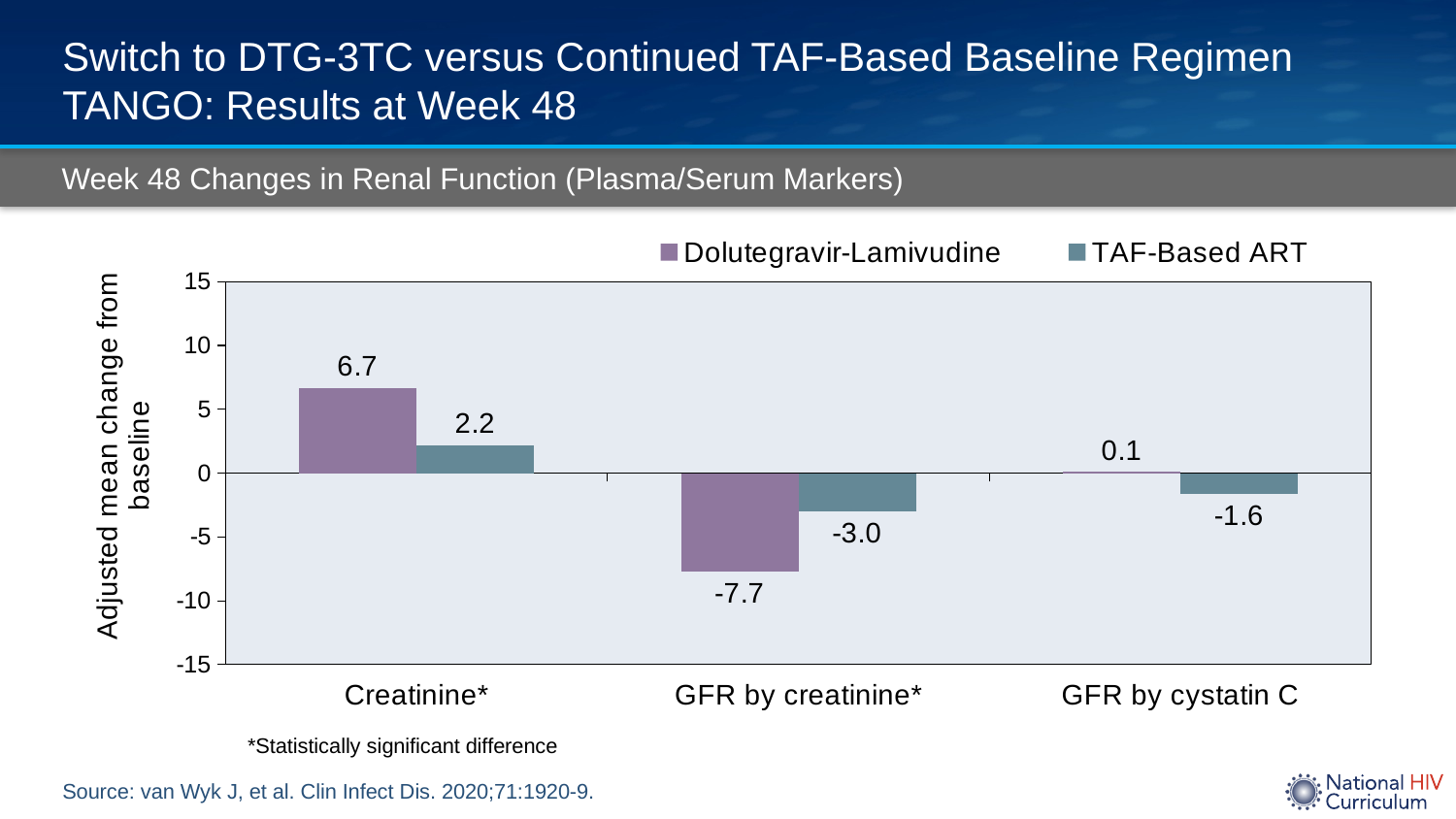
Which category has the lowest value for Dolutegravir-Lamivudine? GFR by creatinine* What is the adjusted mean change from baseline in Creatinine* for Dolutegravir-Lamivudine? 6.7 Which category has the highest value for TAF-Based ART? Creatinine* What is the adjusted mean change from baseline in GFR by cystatin C for Dolutegravir-Lamivudine? 0.1 What is the difference between the Dolutegravir-Lamivudine and TAF-Based ART values for Creatinine*? 4.5 What is the adjusted mean change from baseline in GFR by creatinine* for TAF-Based ART? -3.0 What is the difference between the TAF-Based ART and Dolutegravir-Lamivudine values for GFR by creatinine*? 4.7 How many series does the legend list? 2 What kind of chart is shown on the slide? Bar chart How many categories are shown on the x axis? 3 For GFR by cystatin C, which series has the larger value, Dolutegravir-Lamivudine or TAF-Based ART? Dolutegravir-Lamivudine What is the adjusted mean change from baseline in GFR by cystatin C for TAF-Based ART? -1.6